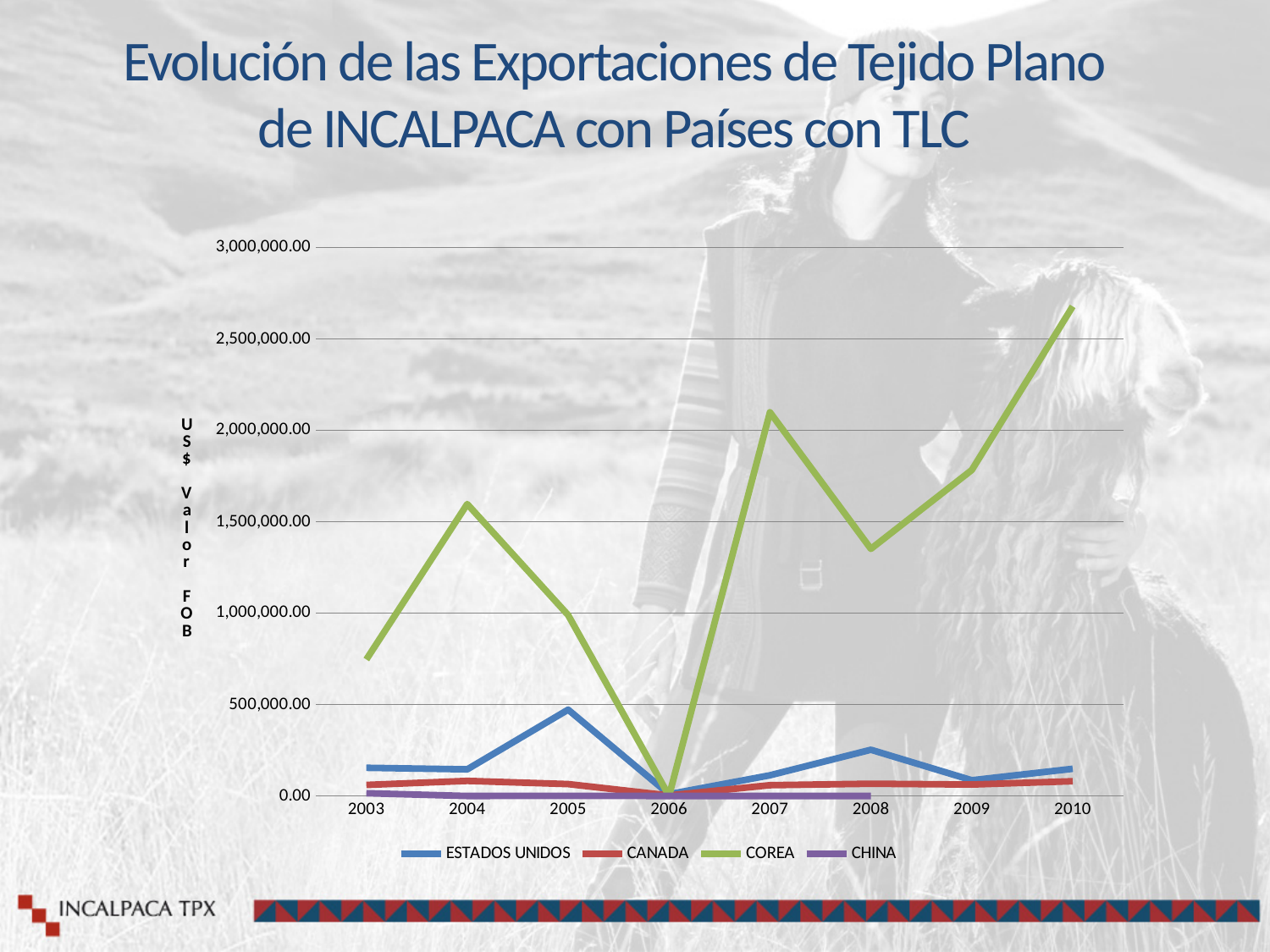
How many years are shown along the x axis? 8 Is the value for COREA in 2008 greater or less than 1,500,000.00? less In which year does the COREA series reach its lowest value? 2006 What is the label on the vertical axis of the chart? US$ Valor FOB How many series does the legend list? 4 Which series has the larger value in 2010, COREA or ESTADOS UNIDOS? COREA What kind of chart is shown on the slide? line chart Does the COREA series rise or fall from 2008 to 2010? rise In which year does the COREA series reach its highest value? 2010 Is the value for COREA in 2010 greater or less than 2,500,000.00? greater In which year does the ESTADOS UNIDOS series reach its highest value? 2005